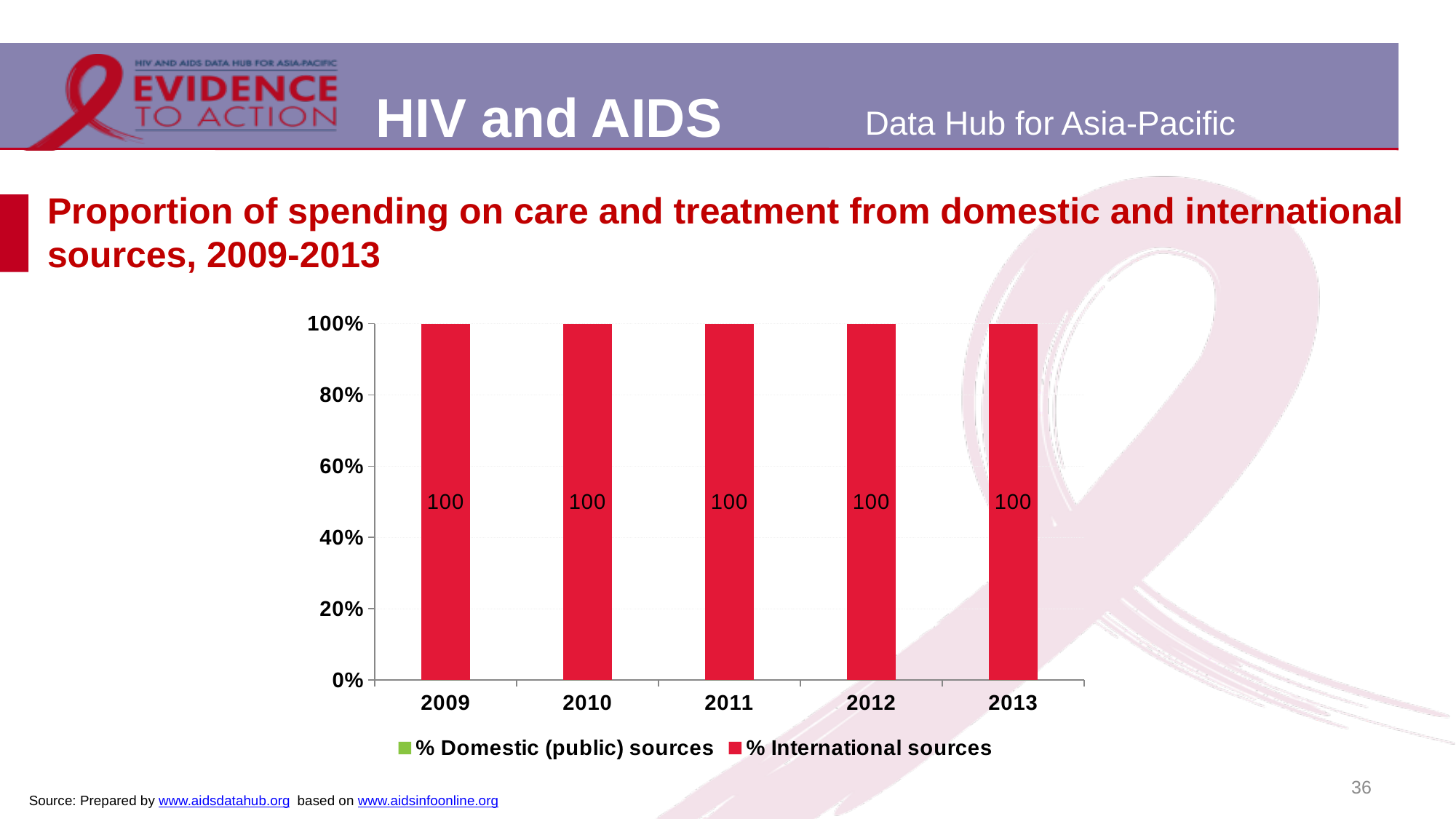
Is the value for % International sources in 2012 greater or less than 80%? greater How many years are shown on the x axis? 5 How many series does the legend list? 2 What is the value for % International sources in 2011? 100 What is the first year shown on the x axis? 2009 Do the % International sources values rise, fall or stay the same from 2009 to 2013? stay the same What is the value for % International sources in 2009? 100 What is the value for % International sources in 2013? 100 What kind of chart is shown on the slide? bar chart Which series is shown in red in the legend? % International sources What is the difference between the % International sources values for 2010 and 2012? 0